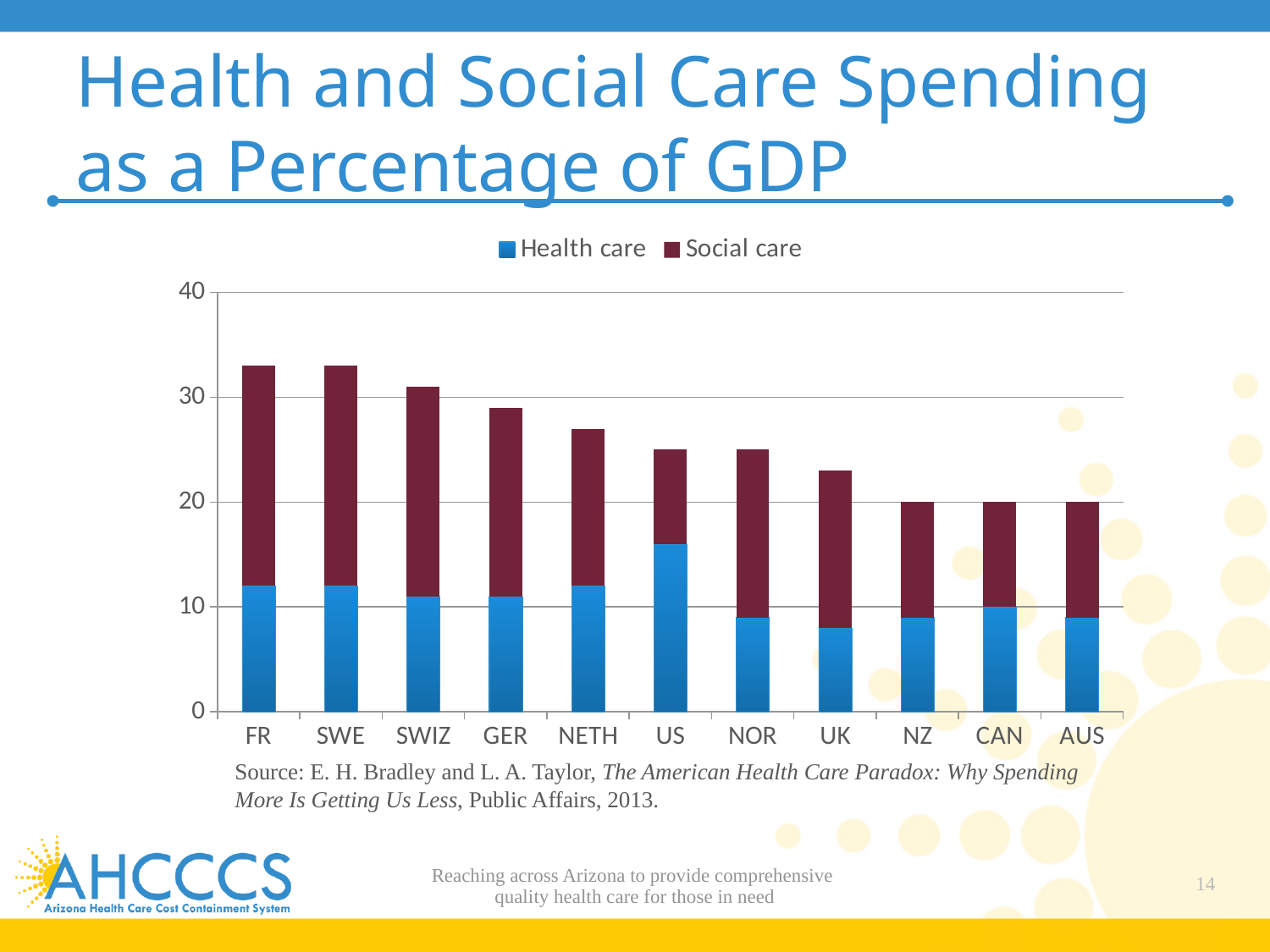
Is the total bar for US greater or less than 30? less What are the two series named in the chart's legend? Health care and Social care Is the Health care value for UK greater or less than 10? less Which has the larger total bar, FR or US? FR Which country has the highest Health care spending as a percentage of GDP? US How many countries are shown on the x axis of the chart? 11 Do the total bar heights generally rise or fall moving from left to right along the x axis? fall What is the total height of the stacked bar for CAN? 20 Is the total bar for FR greater or less than 30? greater How many series does the chart's legend list? 2 What kind of chart is shown on the slide? bar chart